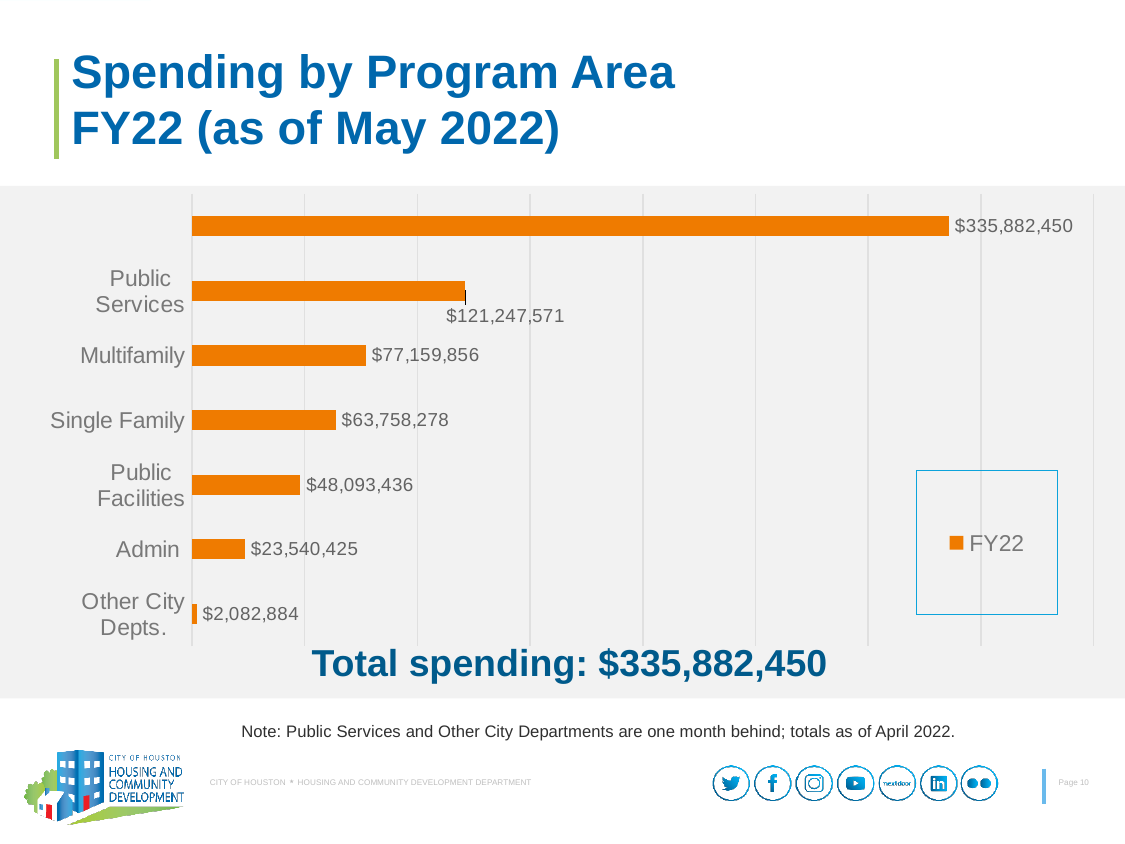
How many series does the legend list? 1 What is the difference between Public Facilities and Admin spending? $24,553,011 What is the difference between Multifamily and Single Family spending? $13,401,578 What is the FY22 spending for Admin? $23,540,425 What is the FY22 spending for Public Services? $121,247,571 Which program area has the lowest spending? Other City Depts. What is the FY22 spending for Other City Depts.? $2,082,884 What is the FY22 spending for Multifamily? $77,159,856 Which is larger, spending for Multifamily or for Single Family? Multifamily What kind of chart is shown on the slide? Bar chart What is the FY22 spending for Public Facilities? $48,093,436 What is the FY22 spending for Single Family? $63,758,278